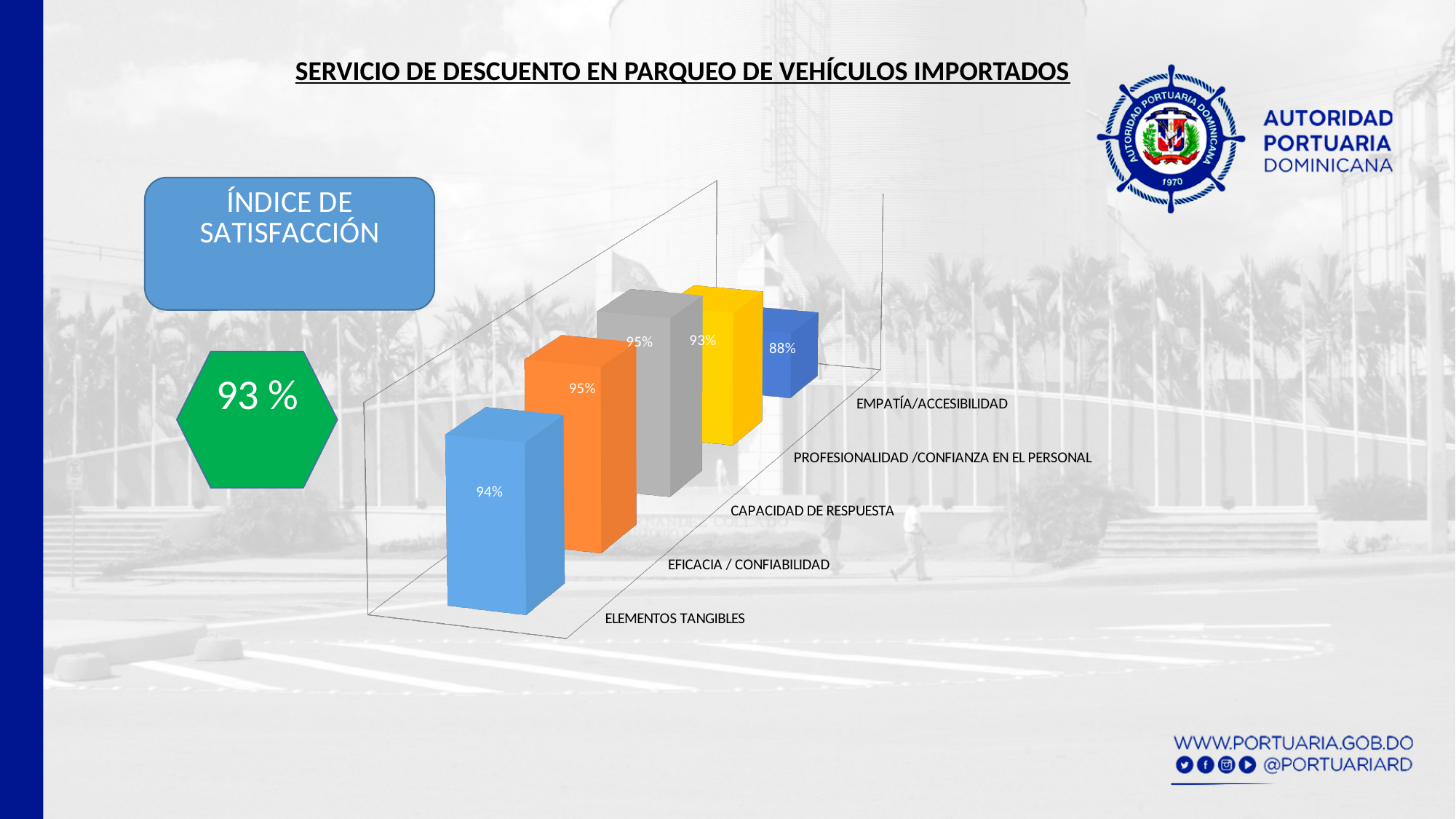
What is the value for PROFESIONALIDAD /CONFIANZA EN EL PERSONAL? 93% What is the difference between the values for ELEMENTOS TANGIBLES and EMPATÍA/ACCESIBILIDAD? 6% What is the difference between the values for EFICACIA / CONFIABILIDAD and PROFESIONALIDAD /CONFIANZA EN EL PERSONAL? 2% How many categories are shown in the chart? 5 What is the value for EFICACIA / CONFIABILIDAD? 95% Which category has the lowest value? EMPATÍA/ACCESIBILIDAD What is the value for CAPACIDAD DE RESPUESTA? 95% What is the value for ELEMENTOS TANGIBLES? 94% What is the value for EMPATÍA/ACCESIBILIDAD? 88% What kind of chart is shown on the slide? bar chart What is the overall satisfaction index shown in the green hexagon on the slide? 93 % Which is larger, the value for ELEMENTOS TANGIBLES or the value for EMPATÍA/ACCESIBILIDAD? ELEMENTOS TANGIBLES